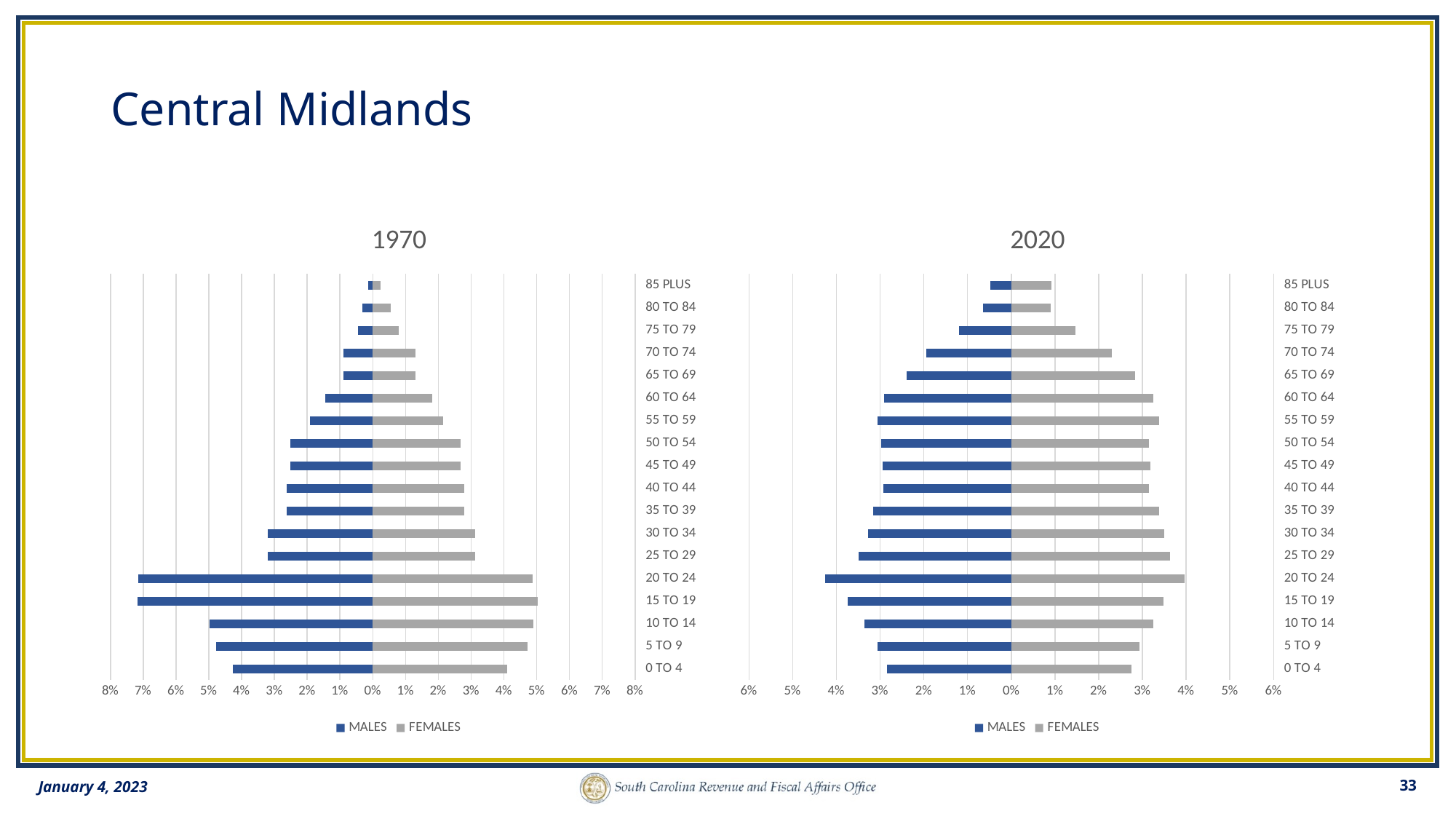
In the 2020 chart, which age group has the largest MALES value? 20 TO 24 In the 1970 chart, is the FEMALES value for 0 TO 4 greater or less than 3%? greater In the 2020 chart, for the 85 PLUS age group, which is larger: MALES or FEMALES? FEMALES How many series does the legend of the 1970 chart list? 2 What colour represents MALES in the legend of the 2020 chart? Blue In the 2020 chart, which age group has the largest FEMALES value? 20 TO 24 What kind of chart is the 1970 chart on the left? Bar chart In the 1970 chart, is the MALES value for 20 TO 24 greater or less than 6%? greater In the 1970 chart, which age group has the smallest MALES value? 85 PLUS How many age groups are plotted in the 2020 chart? 18 In the 1970 chart, for the 20 TO 24 age group, which is larger: MALES or FEMALES? MALES